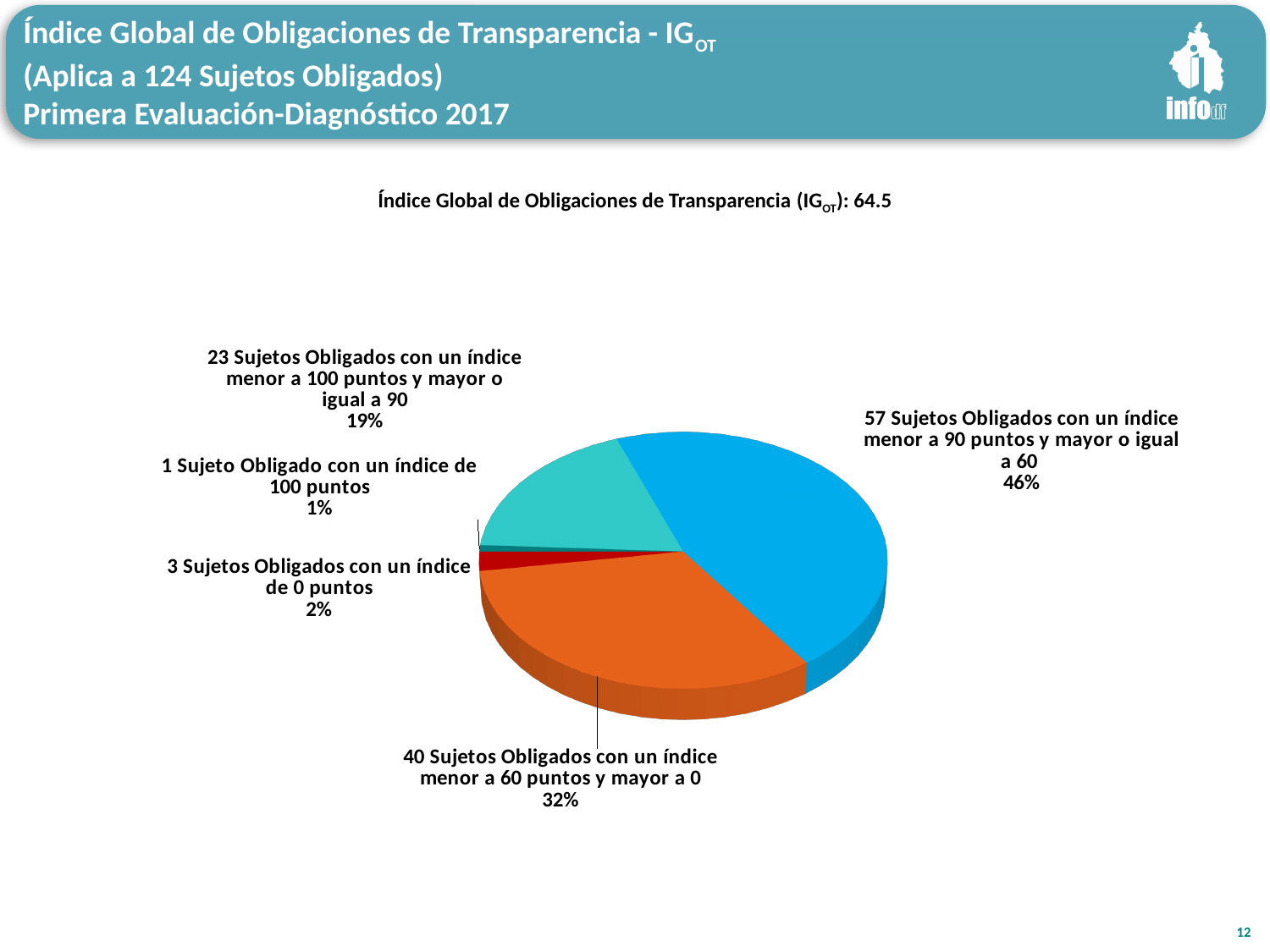
What kind of chart is shown on the slide? Pie chart What percentage share is shown for the 23 Sujetos Obligados with an index below 100 points and greater than or equal to 90? 19% How many Sujetos Obligados have an index of 0 points? 3 Which category has the largest slice of the pie? 57 Sujetos Obligados con un índice menor a 90 puntos y mayor o igual a 60 What value of the Índice Global de Obligaciones de Transparencia (IGOT) is stated above the chart? 64.5 How many Sujetos Obligados have an index of 100 points? 1 What percentage share is shown for the Sujetos Obligados with an index of 0 points? 2% What percentage share is shown for the 40 Sujetos Obligados with an index below 60 points and greater than 0? 32% Which category has the smallest slice of the pie? 1 Sujeto Obligado con un índice de 100 puntos How many slices does the pie chart have? 5 What is the difference in percentage points between the 46% slice and the 32% slice? 14 percentage points